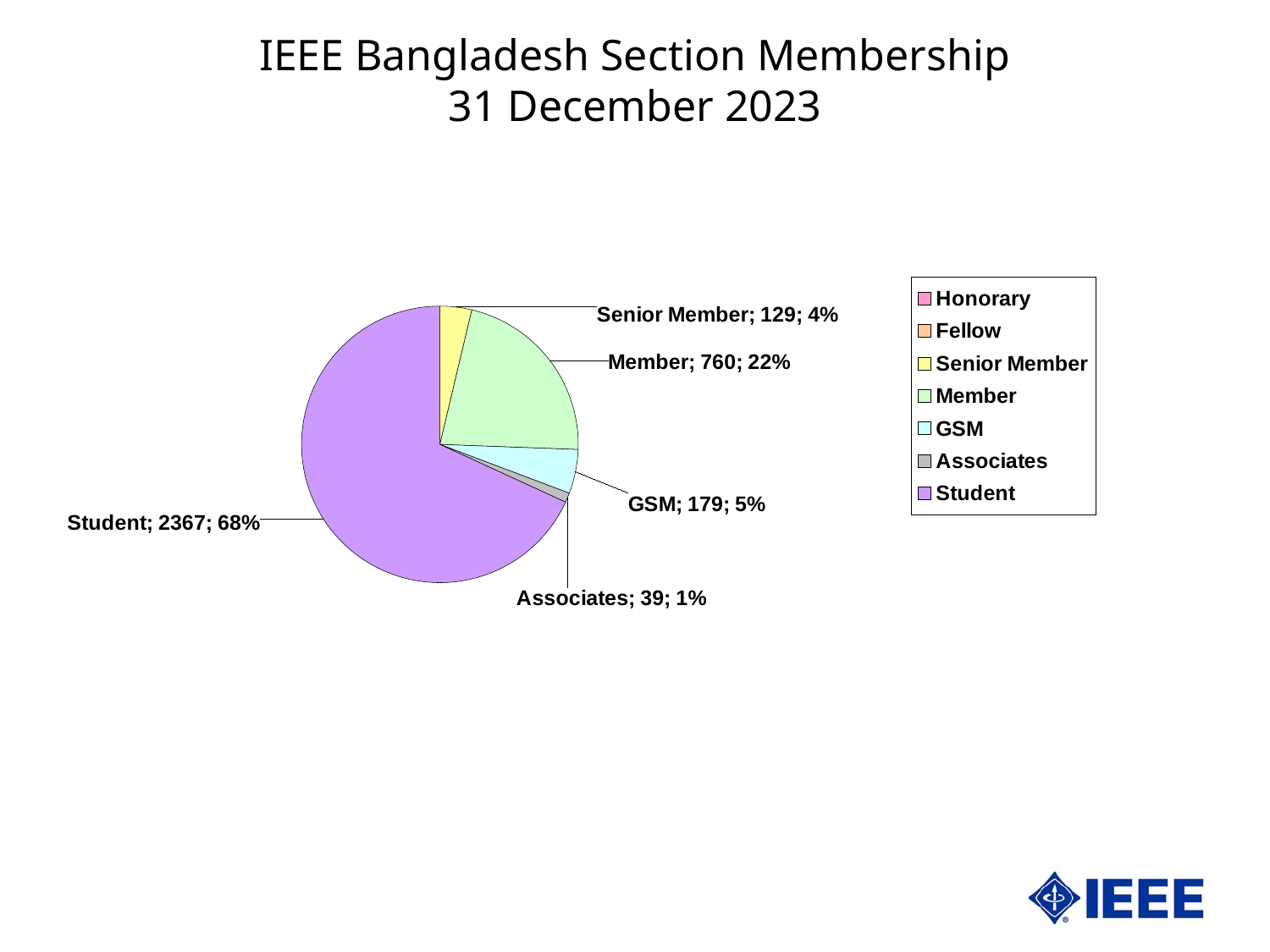
What share of the pie does the Member category represent? 22% How many members are in the GSM category? 179 How many members are in the Student category? 2367 What colour is the Student slice? purple What share of the pie does the Senior Member category represent? 4% What is the difference between the Member count and the Senior Member count? 631 Which category has the largest slice of the pie? Student How many categories does the legend list? 7 Which is larger, the GSM count or the Senior Member count? GSM Which labelled category has the smallest slice of the pie? Associates What kind of chart is shown on the slide? pie chart What is the title of the chart? IEEE Bangladesh Section Membership 31 December 2023